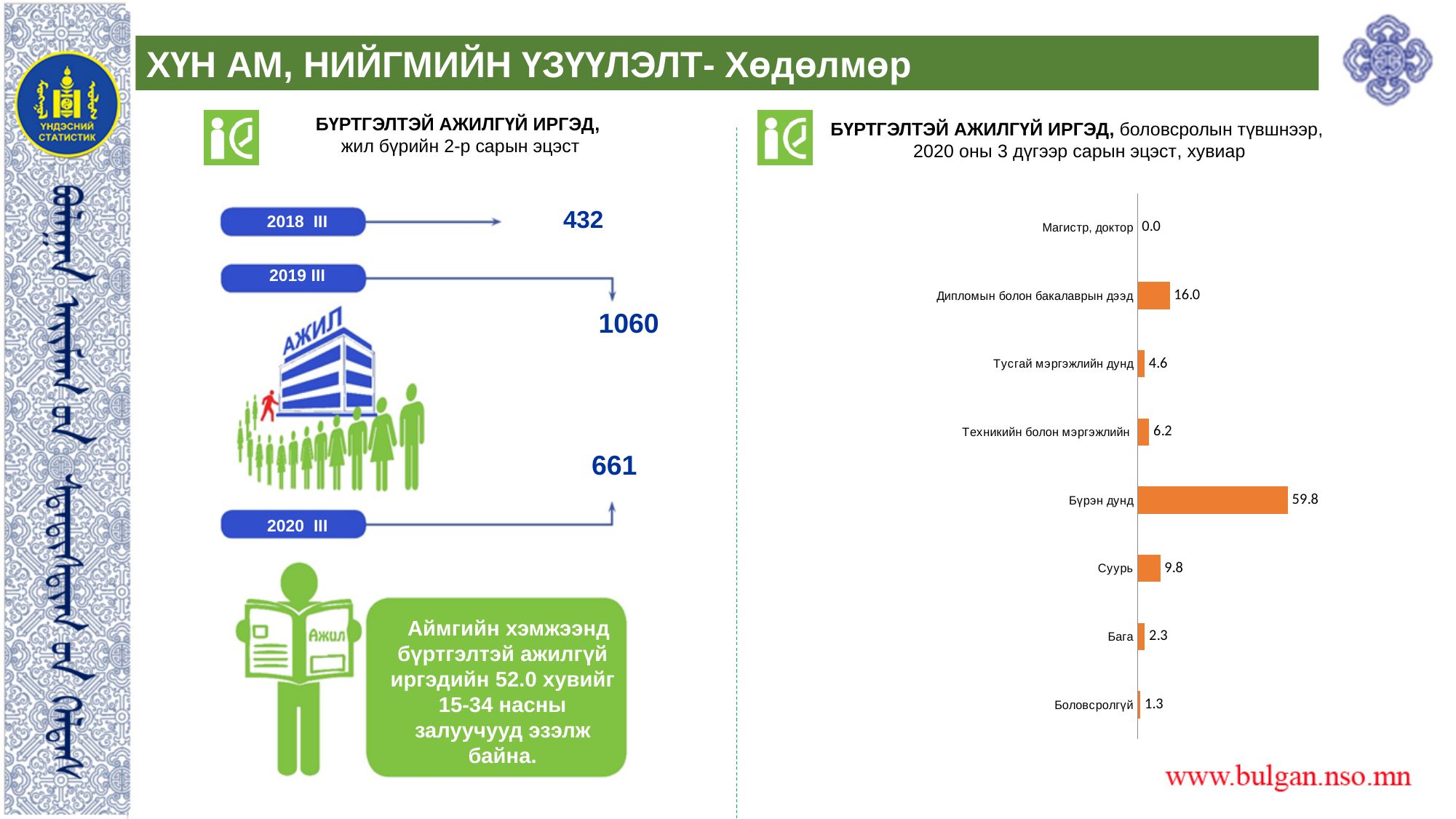
In the bar chart on the right, which category has the highest value? Бүрэн дунд In the bar chart on the right, what is the value for Суурь? 9.8 What colour are the bars in the bar chart on the right? Orange What kind of chart is shown on the right side of the slide? Bar chart In the bar chart on the right, which category has the lowest value? Магистр, доктор In the bar chart on the right, what is the value for Дипломын болон бакалаврын дээд? 16.0 In the bar chart on the right, what is the difference between the values for Бүрэн дунд and Дипломын болон бакалаврын дээд? 43.8 In the bar chart on the right, what is the difference between the values for Суурь and Бага? 7.5 In the bar chart on the right, which is larger: the value for Техникийн болон мэргэжлийн or the value for Тусгай мэргэжлийн дунд? Техникийн болон мэргэжлийн In the bar chart on the right, what is the value for Бүрэн дунд? 59.8 In the bar chart on the right, what is the value for Боловсролгүй? 1.3 How many categories are shown in the bar chart on the right? 8